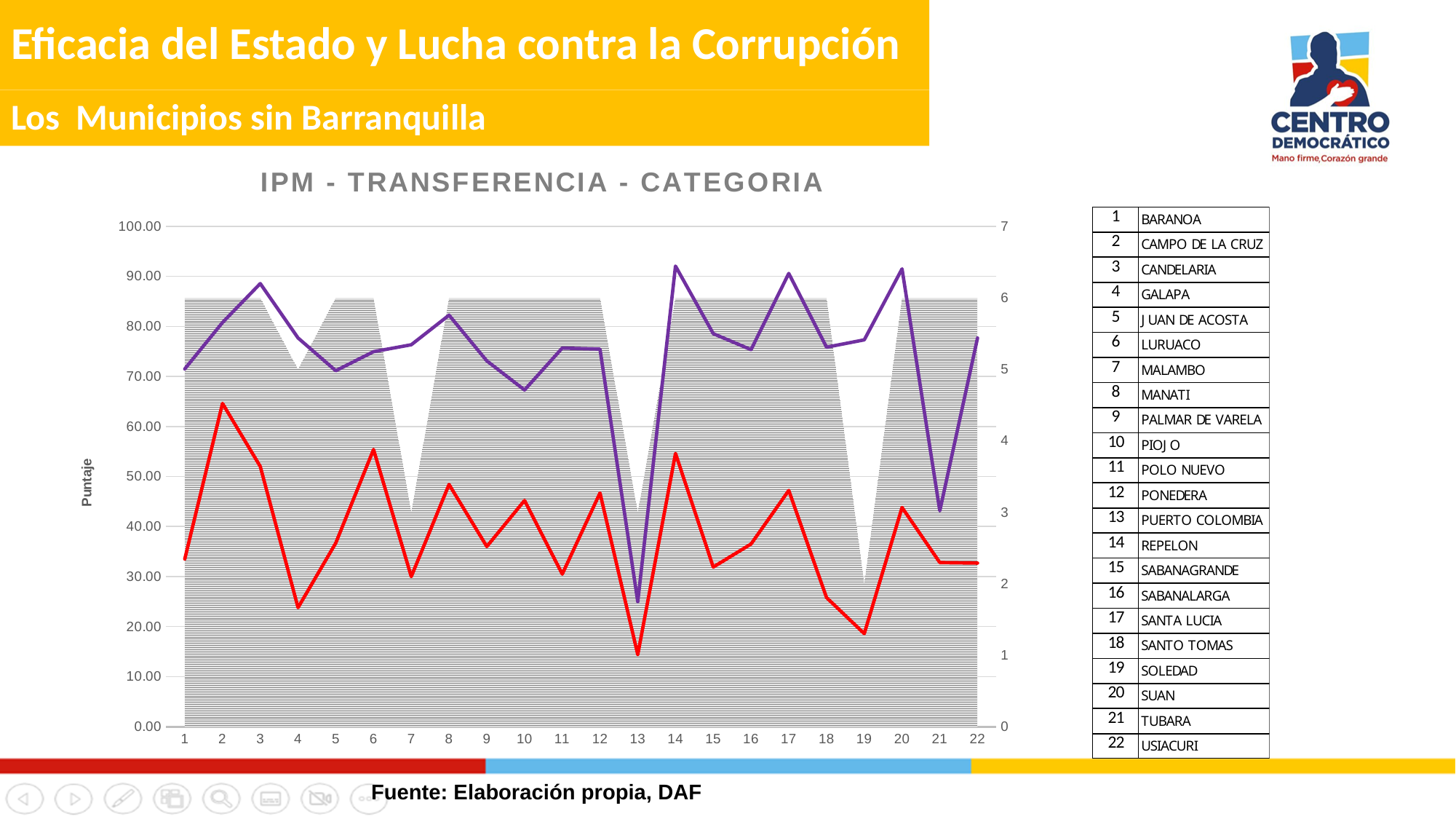
How many points are plotted along the x axis of the chart? 22 What kind of chart is shown on the slide? combination area and line chart What is the label of the left vertical axis? Puntaje Is the value of the red line at point 13 greater or less than 20.00? less Is the value of the purple line at point 13 greater or less than 30.00? less At which x-axis point does the red line reach its highest value? 2 Which is larger: the purple line's value at point 13 or at point 14? point 14 Is the value of the red line at point 2 greater or less than 60.00? greater Does the purple line rise or fall from point 20 to point 21? fall At which x-axis point does the purple line reach its lowest value? 13 What is the title of the chart? IPM - TRANSFERENCIA - CATEGORIA At which x-axis point does the red line reach its lowest value? 13